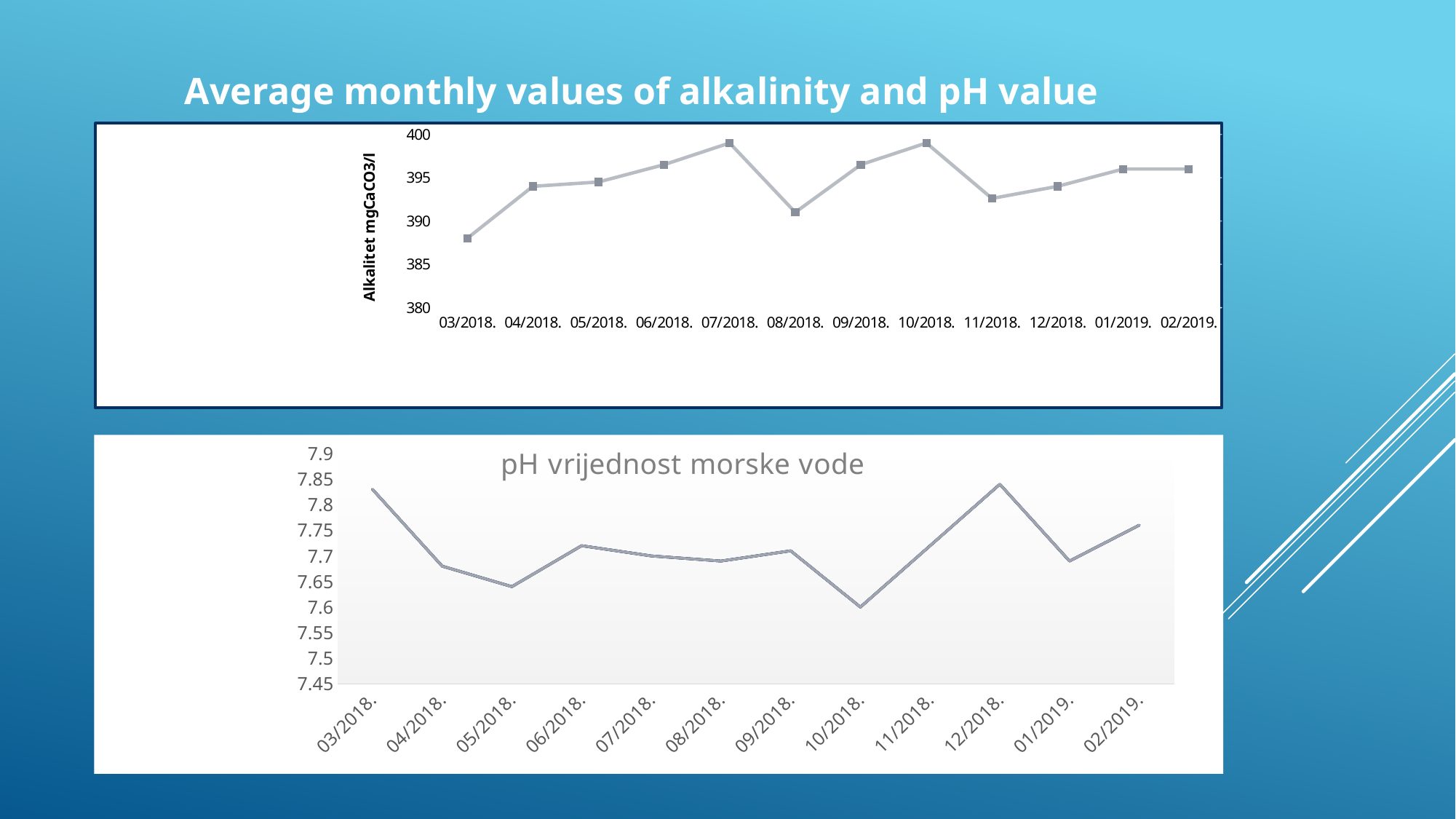
In the bottom pH chart, which month has the larger pH value, 03/2018. or 10/2018.? 03/2018. In the top alkalinity chart, how many months are plotted along the x axis? 12 In the bottom pH chart, which month has the lowest pH value? 10/2018. In the bottom pH chart, is the value for 12/2018. greater or less than 7.8? greater In the bottom pH chart, is the value for 10/2018. greater or less than 7.65? less In the top alkalinity chart, which month has the lowest alkalinity value? 03/2018. In the bottom pH chart, how many data points are plotted? 12 What kind of chart is the bottom chart titled 'pH vrijednost morske vode'? line chart In the top alkalinity chart, is the value for 07/2018. greater or less than 395? greater In the top alkalinity chart, do the values rise or fall from 03/2018. to 07/2018.? rise What kind of chart is the top chart showing alkalinity? line chart